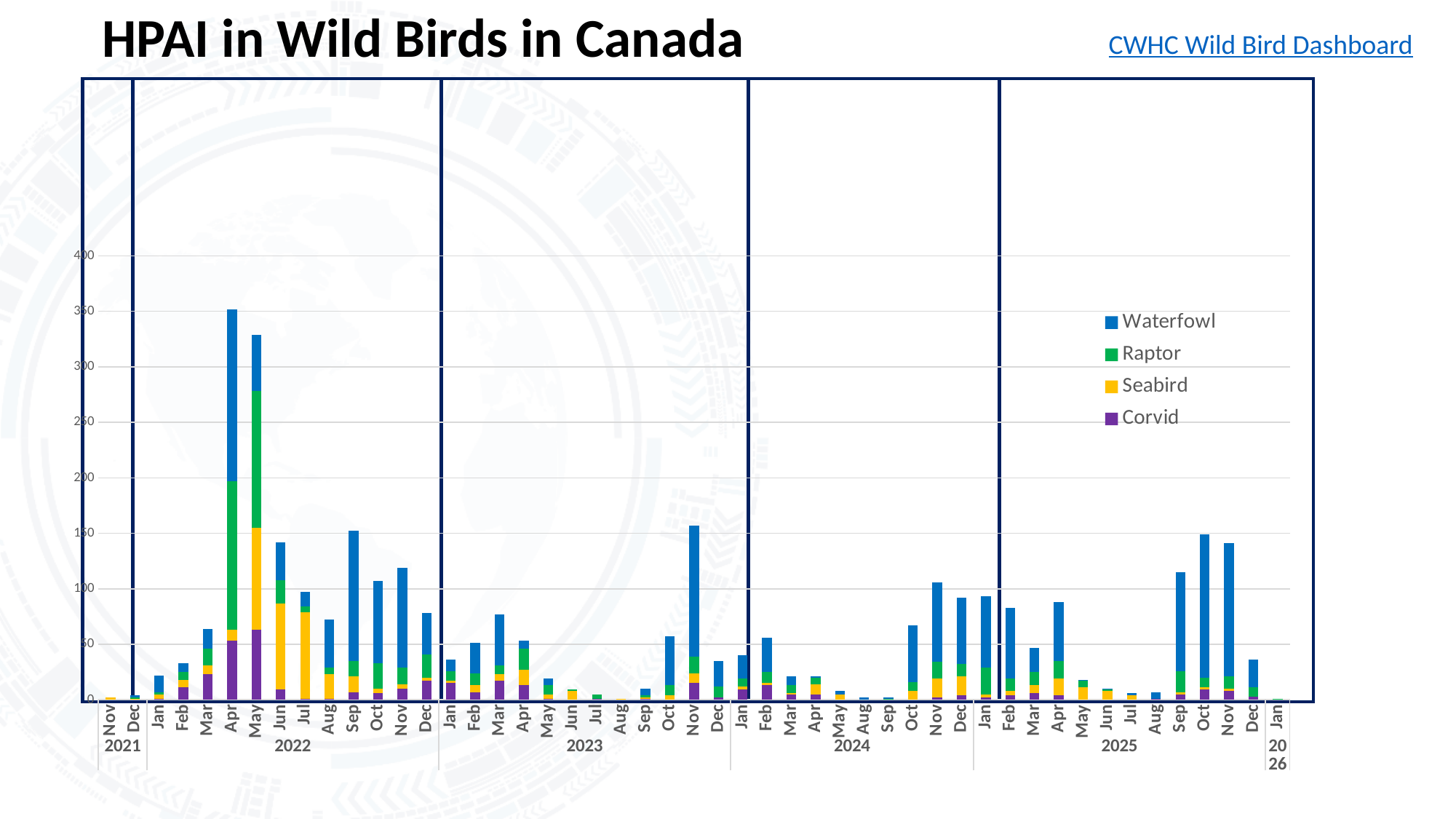
How many series does the legend list? 4 Do the bar totals rise or fall from Apr 2022 to Aug 2022? fall Which month has the tallest bar in the chart? Apr 2022 What is the title of the slide's chart? HPAI in Wild Birds in Canada Which series are listed in the legend? Waterfowl, Raptor, Seabird, Corvid Which bar is taller, Apr 2022 or Nov 2023? Apr 2022 Is the total for May 2022 greater or less than 300? greater Is the total for Apr 2022 greater or less than 300? greater What kind of chart is shown on the slide? Stacked bar chart Which bar is taller, Sep 2022 or Nov 2022? Sep 2022 Is the total for Nov 2023 greater or less than 100? greater